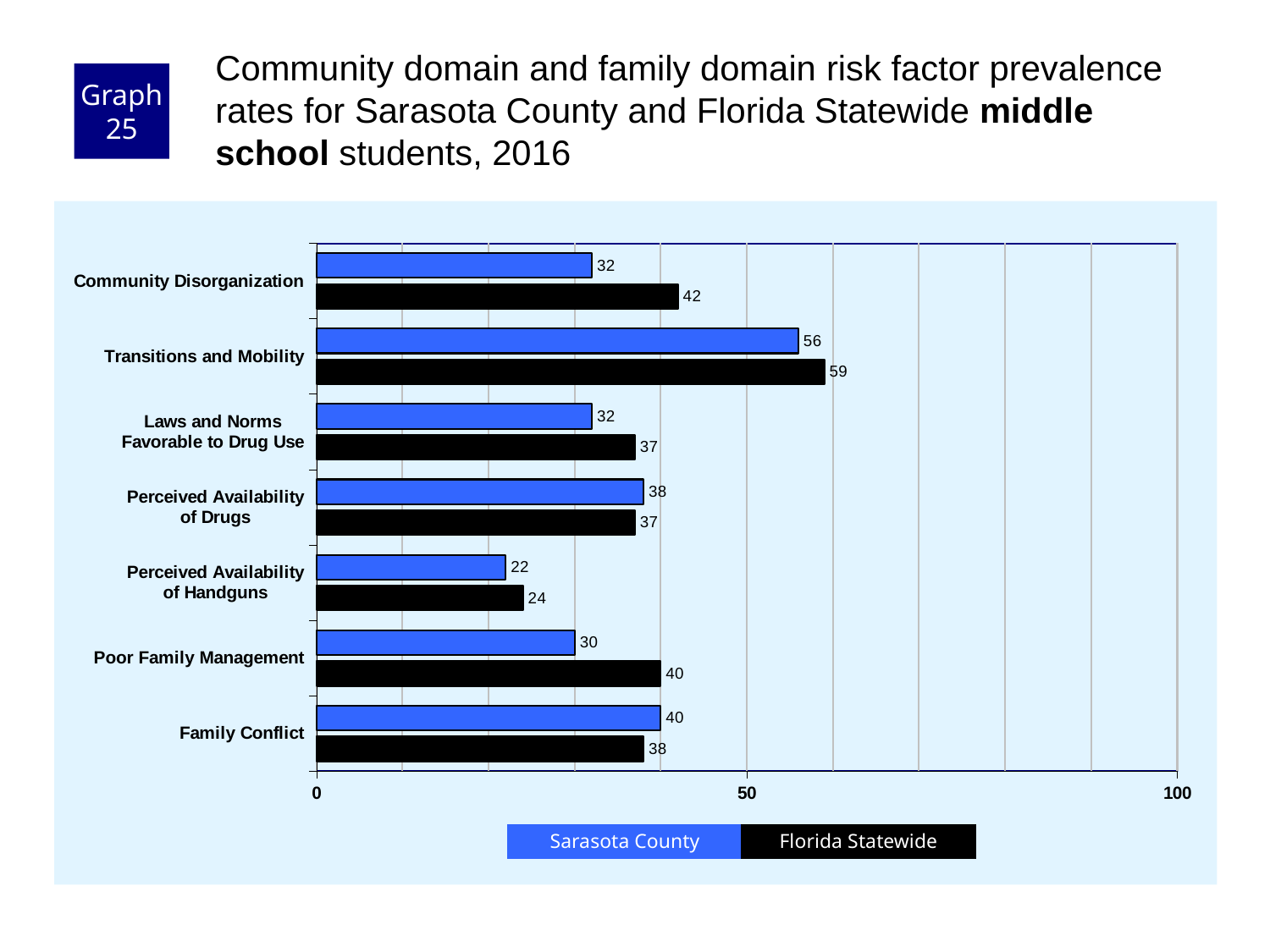
What kind of chart is shown on the slide? bar chart How many series does the legend list? 2 Which risk factor has the highest Florida Statewide value? Transitions and Mobility For Family Conflict, which is larger: the Sarasota County value or the Florida Statewide value? Sarasota County What is the Florida Statewide value for Poor Family Management? 40 How many risk factor categories are shown on the chart? 7 What is the Sarasota County value for Perceived Availability of Handguns? 22 Which risk factor has the lowest Sarasota County value? Perceived Availability of Handguns What is the difference between the Florida Statewide and Sarasota County values for Poor Family Management? 10 Is the Florida Statewide value for Transitions and Mobility greater or less than 50? greater What is the difference between the Florida Statewide and Sarasota County values for Community Disorganization? 10 What is the Sarasota County value for Transitions and Mobility? 56